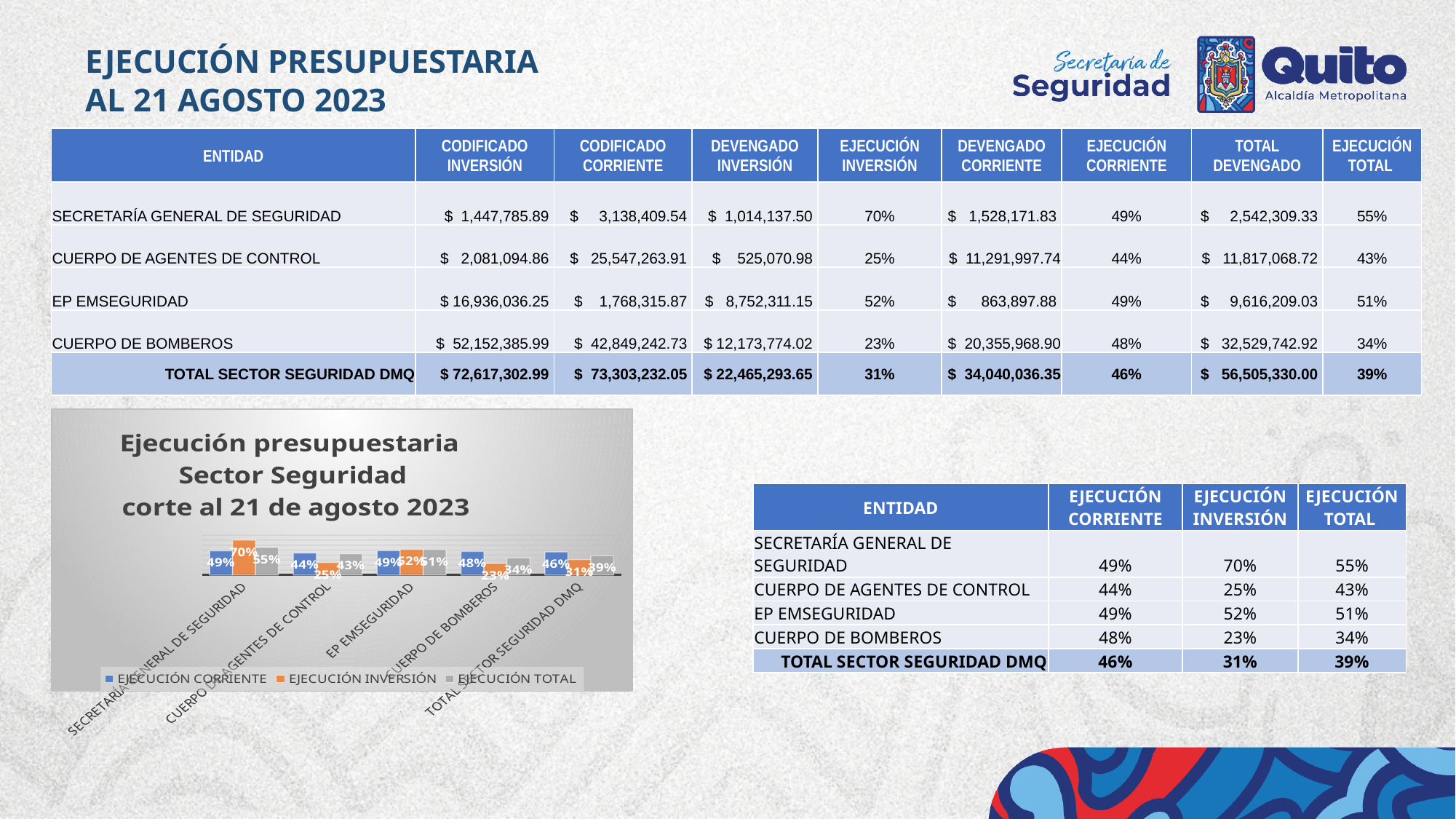
What kind of chart is shown on the slide? bar chart How many series does the chart legend list? 3 What is the EJECUCIÓN INVERSIÓN value for SECRETARÍA GENERAL DE SEGURIDAD in the chart? 70% What is the EJECUCIÓN CORRIENTE value for TOTAL SECTOR SEGURIDAD DMQ in the chart? 46% Which entity has the highest EJECUCIÓN INVERSIÓN value in the chart? SECRETARÍA GENERAL DE SEGURIDAD What is the EJECUCIÓN TOTAL value for CUERPO DE BOMBEROS in the chart? 34% Which entity has the lowest EJECUCIÓN INVERSIÓN value in the chart? CUERPO DE BOMBEROS In the chart, what is the difference between the EJECUCIÓN INVERSIÓN values of SECRETARÍA GENERAL DE SEGURIDAD and CUERPO DE BOMBEROS? 47% In the chart, which is larger for EP EMSEGURIDAD: EJECUCIÓN CORRIENTE or EJECUCIÓN INVERSIÓN? EJECUCIÓN INVERSIÓN How many entities (categories) are plotted along the x axis of the chart? 5 What is the title of the chart on the slide? Ejecución presupuestaria Sector Seguridad corte al 21 de agosto 2023 Which series in the chart is shown in orange? EJECUCIÓN INVERSIÓN